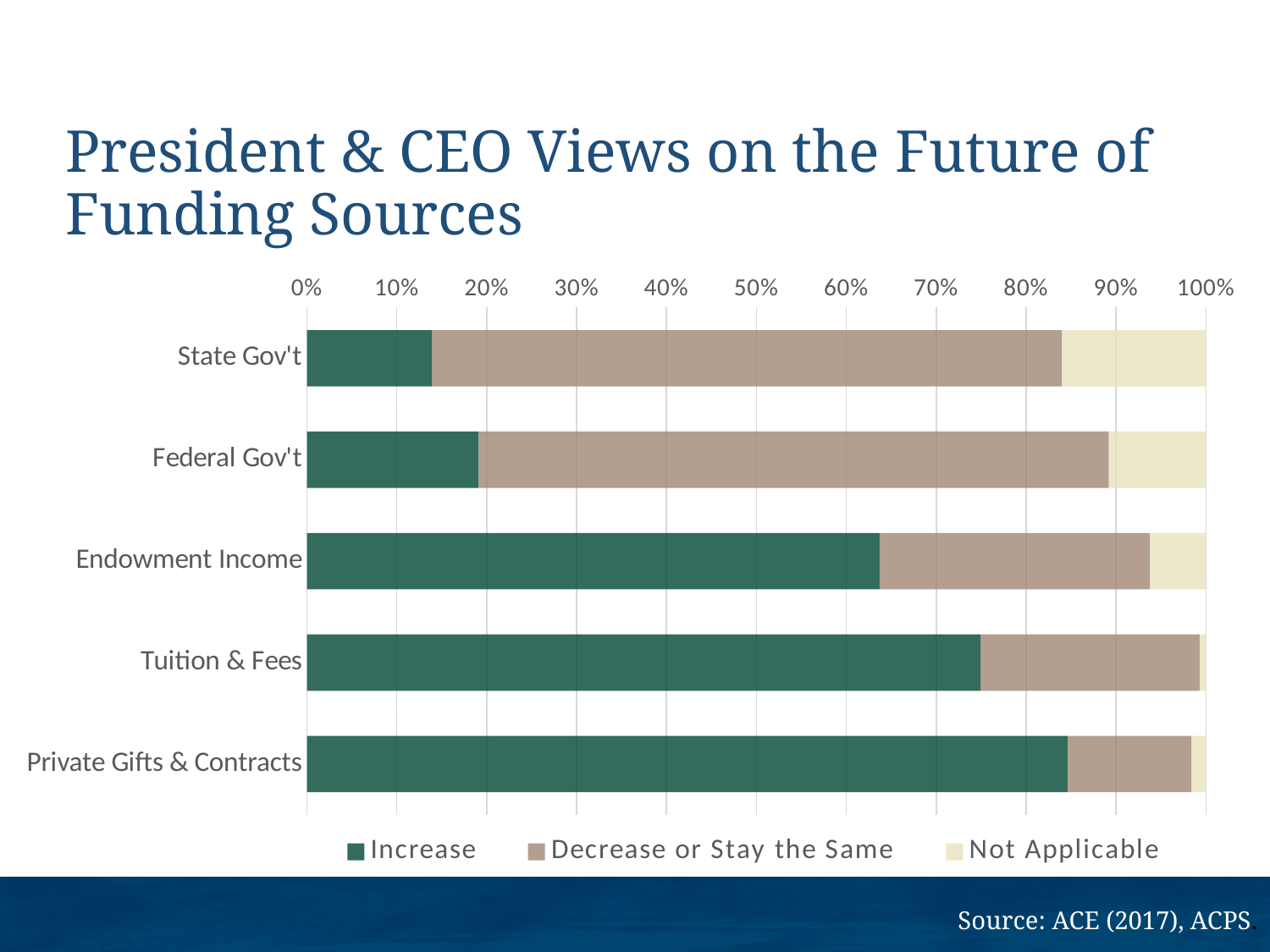
Is the 'Increase' share for Private Gifts & Contracts greater or less than 80%? greater What kind of chart is shown on the slide? Stacked bar chart Is the 'Increase' share for Endowment Income greater or less than 60%? greater How many funding source categories are plotted on the chart? 5 Is the 'Increase' share for Federal Gov't greater or less than 30%? less Which funding source has the largest 'Increase' share? Private Gifts & Contracts Which has a larger 'Not Applicable' share, State Gov't or Federal Gov't? State Gov't What is the title of the chart on the slide? President & CEO Views on the Future of Funding Sources How many series does the legend list? 3 Which funding source has the smallest 'Increase' share? State Gov't Which has a larger 'Increase' share, Endowment Income or Tuition & Fees? Tuition & Fees